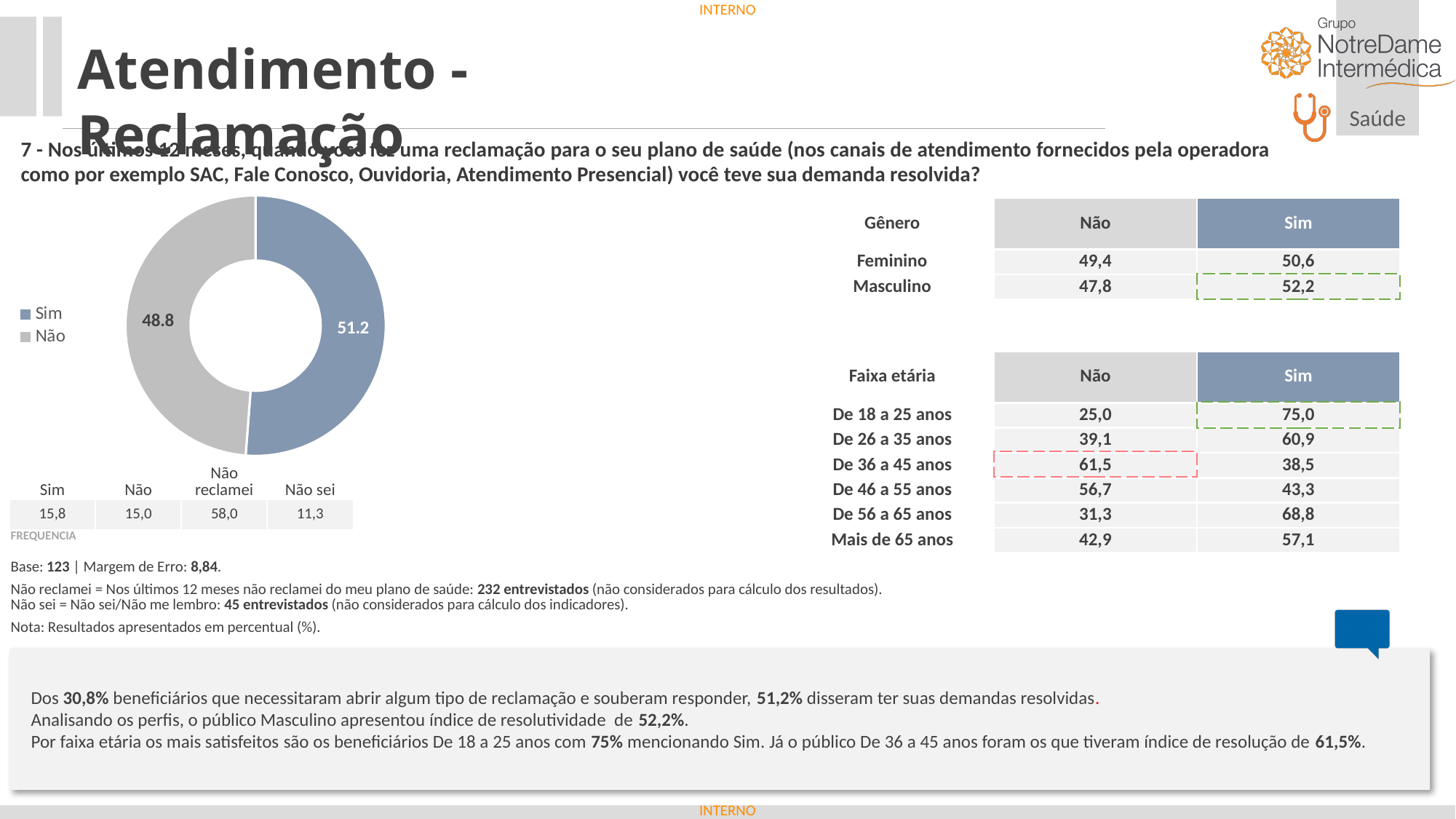
Which slice of the donut chart is the smallest? Não Which slice of the donut chart is the largest? Sim How many entries does the legend of the donut chart list? 2 How many slices does the donut chart have? 2 What share of the donut chart does the "Sim" slice represent? 51.2% Which colour represents "Não" in the donut chart? Grey What is the difference between the "Sim" and "Não" values in the donut chart? 2.4 What is the value shown for the "Sim" slice of the donut chart? 51.2 Which colour represents "Sim" in the donut chart? Blue What is the value shown for the "Não" slice of the donut chart? 48.8 In the donut chart, is the value for "Sim" larger or smaller than the value for "Não"? Larger What kind of chart is shown on the slide? Donut (pie) chart